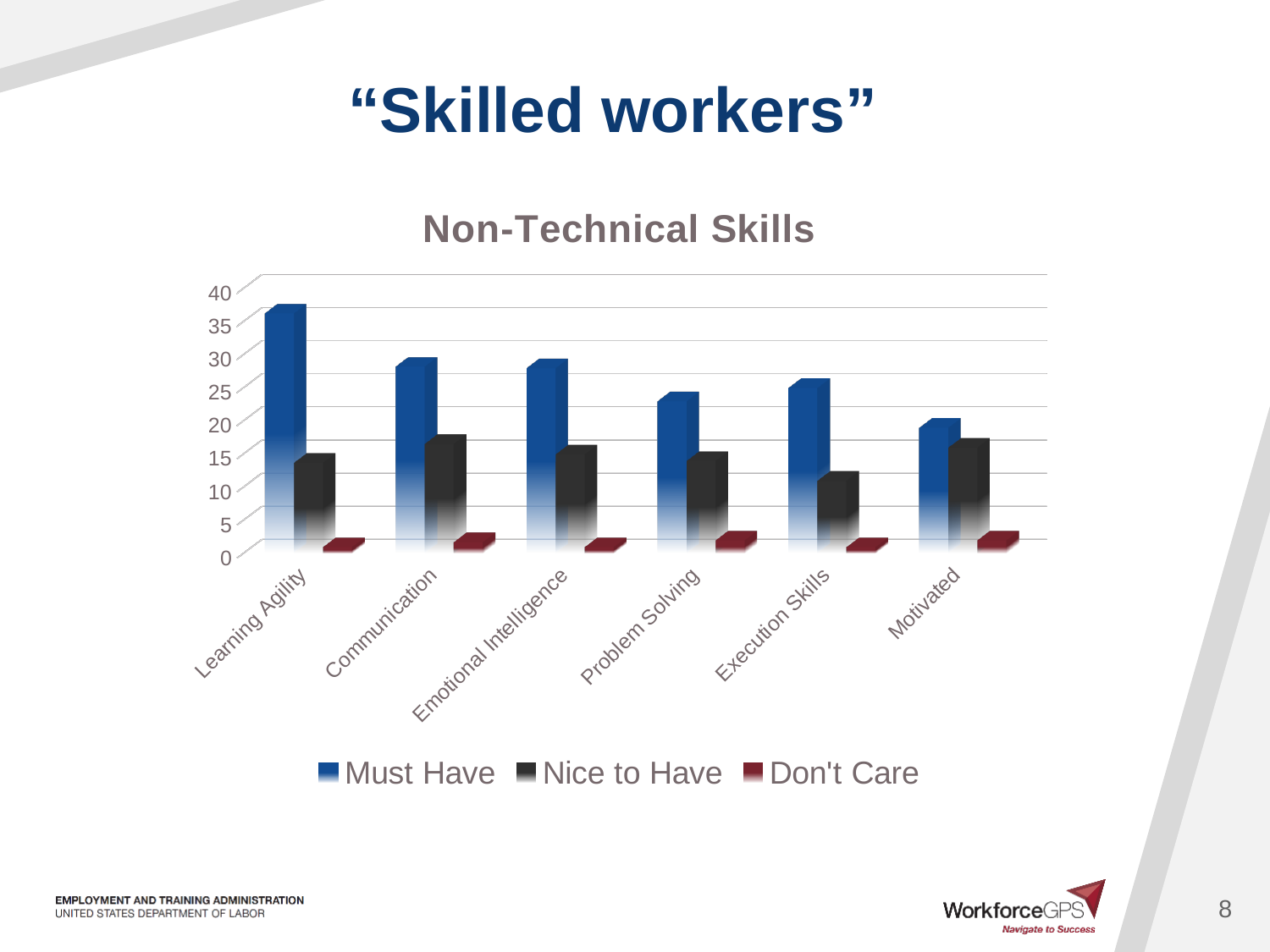
How many series does the legend list? 3 What is the title of the chart? Non-Technical Skills Is the 'Nice to Have' value for Execution Skills greater or less than 15? less Is the 'Must Have' value for Learning Agility greater or less than 30? greater Which skill has the lowest 'Nice to Have' value? Execution Skills What kind of chart is shown on the slide? Bar chart Which is larger: the 'Nice to Have' value for Communication or for Execution Skills? Communication Is the 'Must Have' value for Motivated greater or less than 25? less How many skill categories are shown on the x axis? 6 Which skill has the lowest 'Must Have' value? Motivated Which series is shown in dark red in the legend? Don't Care Which skill has the highest 'Must Have' value? Learning Agility